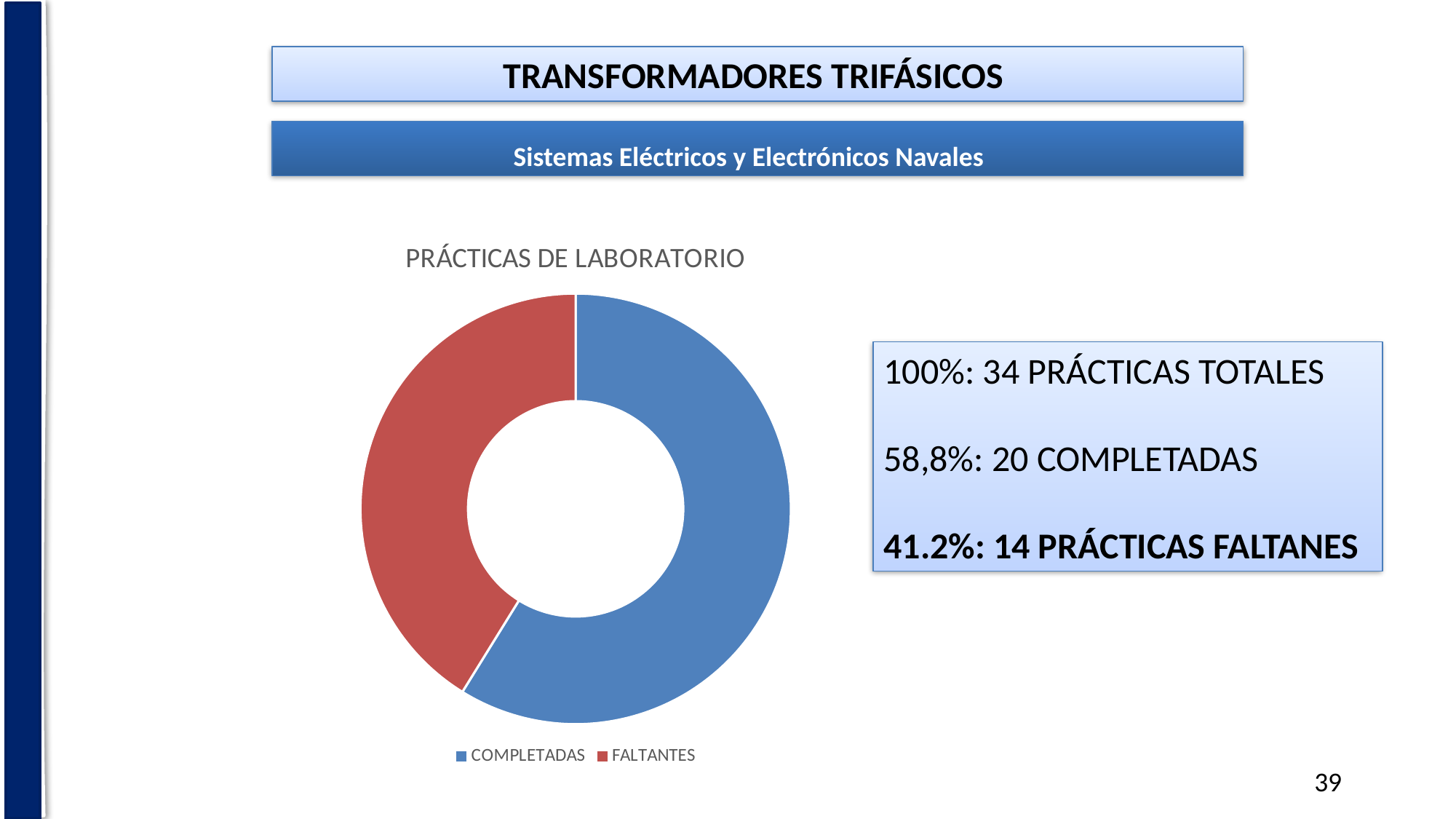
What is the difference between the number of COMPLETADAS and FALTANTES prácticas? 6 Is the COMPLETADAS slice larger or smaller than the FALTANTES slice? larger What percentage share of the chart does COMPLETADAS represent? 58,8% What kind of chart is shown on the slide? doughnut chart What is the title of the chart? PRÁCTICAS DE LABORATORIO What percentage share of the chart does FALTANTES represent? 41.2% How many entries does the chart legend list? 2 Which category takes the smaller share of the doughnut chart? FALTANTES Which category takes the larger share of the doughnut chart? COMPLETADAS How many prácticas are COMPLETADAS according to the slide? 20 How many categories does the chart show? 2 How many prácticas are FALTANTES according to the slide? 14